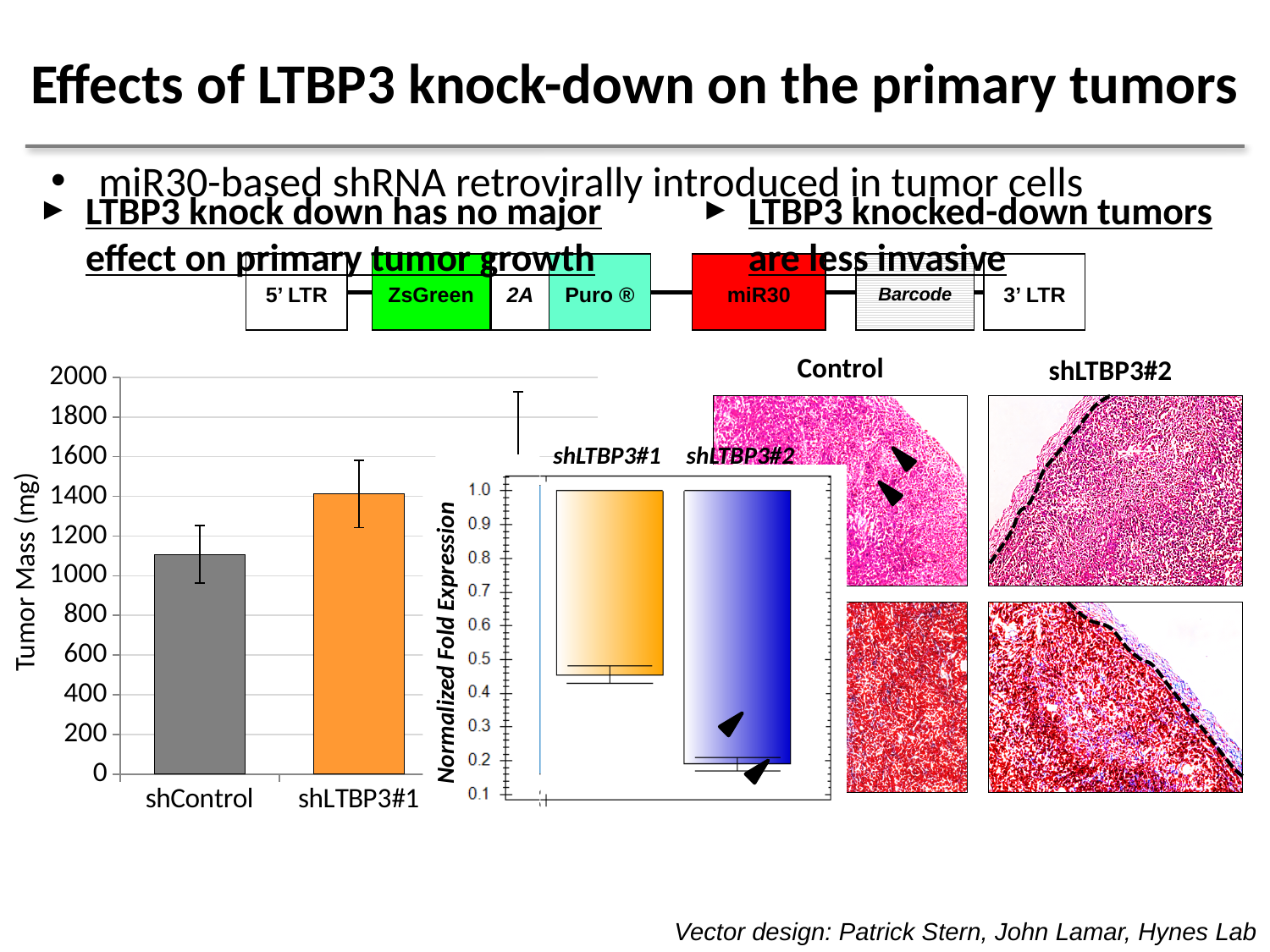
What kind of chart is the Tumor Mass (mg) chart on the left of the slide? bar chart What is the y-axis label of the bar chart on the left of the slide? Tumor Mass (mg) In the Normalized Fold Expression inset chart, is the value for shLTBP3#1 greater or less than 0.4? greater In the Tumor Mass (mg) chart, which of shControl and shLTBP3#1 has the larger tumor mass? shLTBP3#1 In the Normalized Fold Expression inset chart, which category has the lower normalized fold expression, shLTBP3#1 or shLTBP3#2? shLTBP3#2 In the Tumor Mass (mg) chart, is the value for shControl greater or less than 1200? less What kind of chart is the Normalized Fold Expression inset chart? bar chart In the Tumor Mass (mg) chart, is the value for shLTBP3#1 greater or less than 1200? greater What is the highest tick value on the y axis of the Tumor Mass (mg) chart? 2000 How many categories are shown in the Normalized Fold Expression inset chart? 2